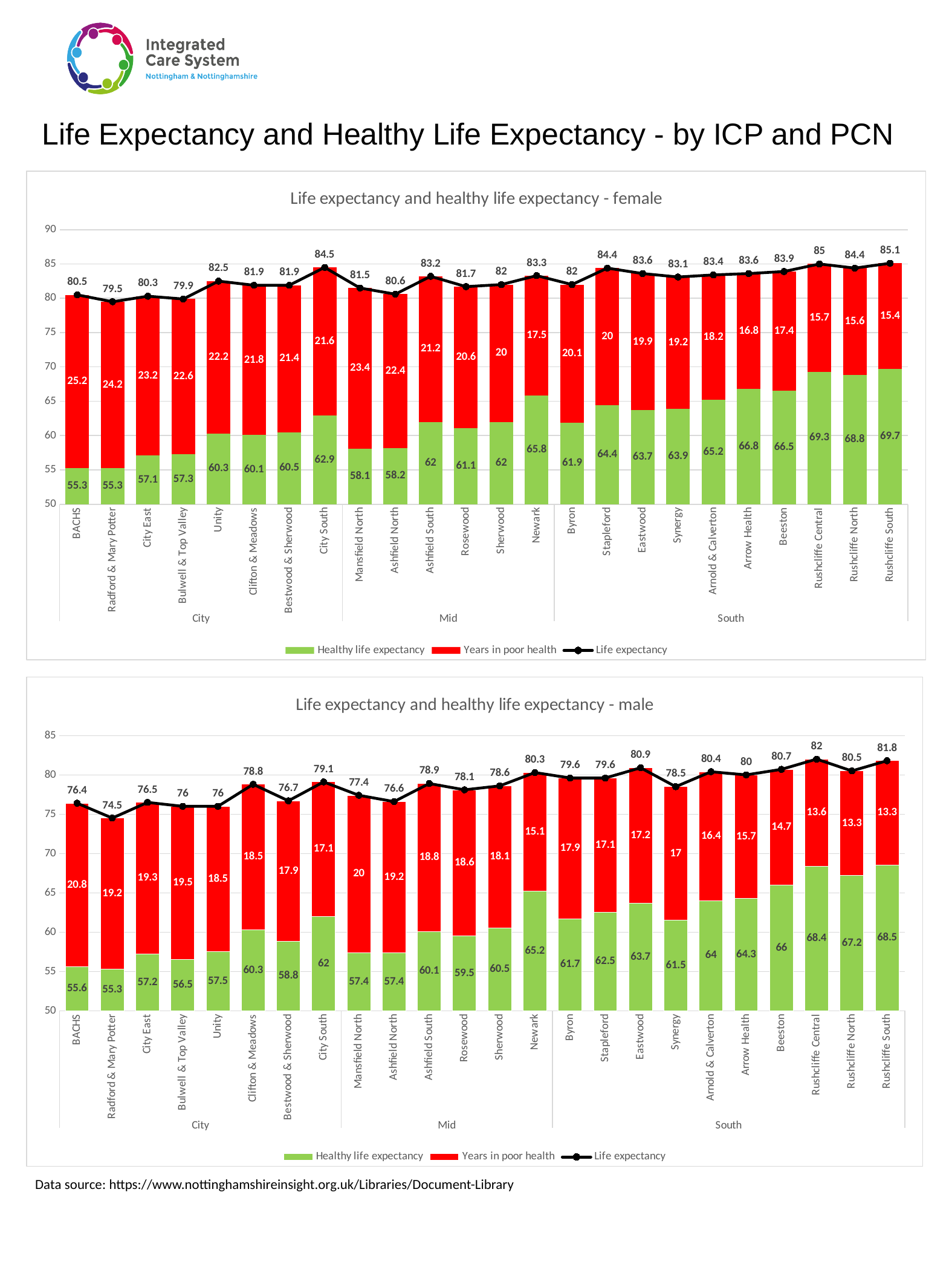
In the female chart, what is the healthy life expectancy for Rushcliffe South? 69.7 In the male chart, which PCN has the lowest life expectancy? Radford & Mary Potter In the female chart, what is the life expectancy for City South? 84.5 In the male chart, what is the difference in years in poor health between BACHS and Rushcliffe North? 7.5 How many series does the legend of the female chart list? 3 How many PCNs are shown along the x axis of the male chart? 24 In the male chart, what is the healthy life expectancy for Newark? 65.2 In the female chart, which PCN has the lowest life expectancy? Radford & Mary Potter In the male chart, which has the higher healthy life expectancy, Stapleford or Synergy? Stapleford In the female chart, which PCN has the highest life expectancy? Rushcliffe South In the male chart, what is the life expectancy for Rushcliffe Central? 82 In the female chart, how many years in poor health are shown for BACHS? 25.2